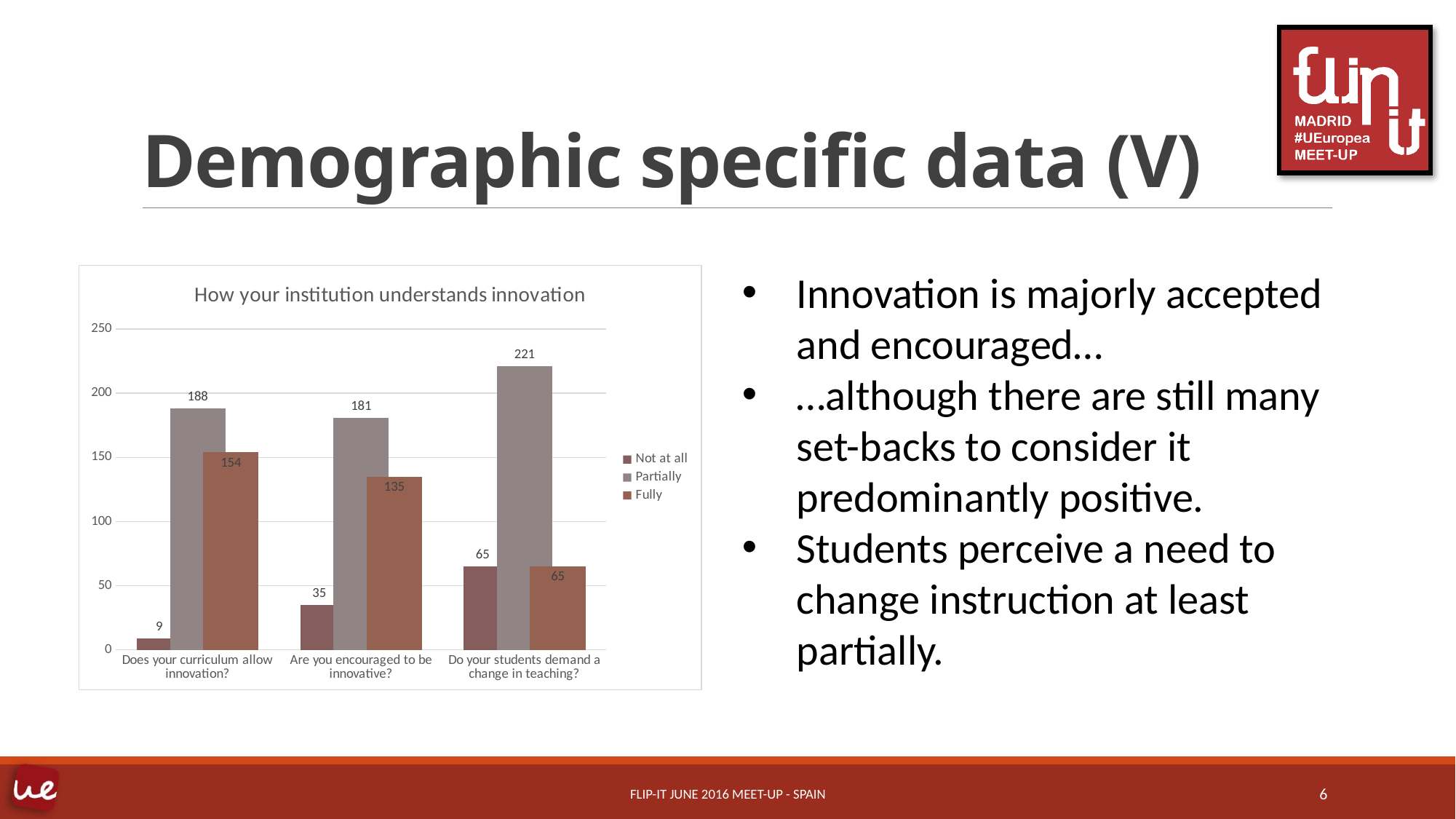
How many series does the chart legend list? 3 What is the difference between the 'Partially' and 'Fully' values for 'Are you encouraged to be innovative?'? 46 What is the 'Not at all' value for 'Are you encouraged to be innovative?'? 35 What type of chart is shown on the slide? bar chart Which category has the lowest 'Not at all' value? Does your curriculum allow innovation? What is the title of the chart? How your institution understands innovation Do the 'Not at all' values rise or fall from left to right across the categories? rise What is the 'Partially' value for 'Does your curriculum allow innovation?'? 188 Which is larger for 'Does your curriculum allow innovation?': the 'Partially' value or the 'Fully' value? Partially How many question categories are shown on the x axis of the chart? 3 Which category has the highest 'Partially' value? Do your students demand a change in teaching? What is the 'Fully' value for 'Do your students demand a change in teaching?'? 65